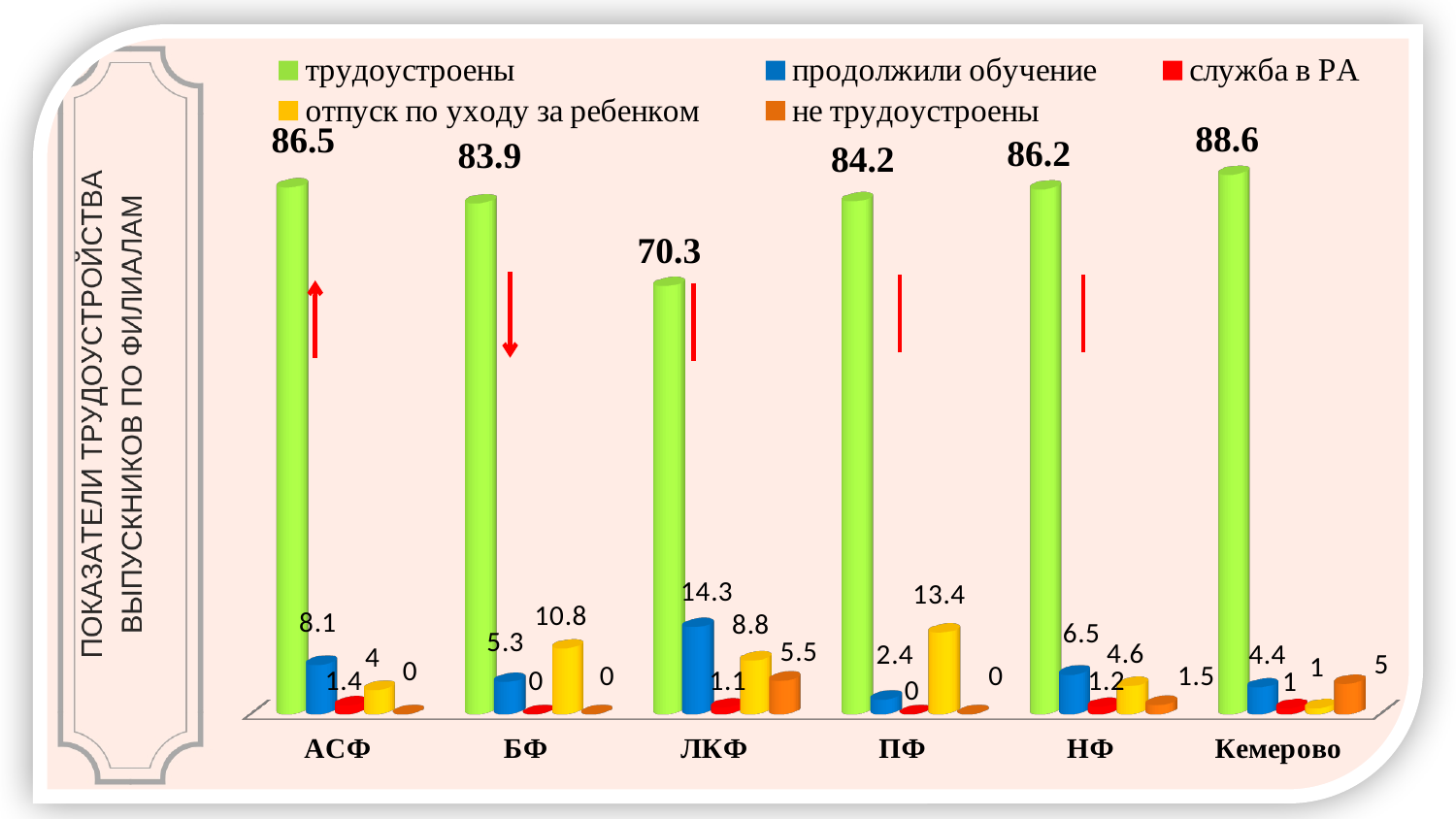
Which legend entry is shown in red? служба в РА What is the value of продолжили обучение for ЛКФ? 14.3 What is the value of трудоустроены for Кемерово? 88.6 What is the value of не трудоустроены for НФ? 1.5 What is the difference between the трудоустроены values for Кемерово and ЛКФ? 18.3 What kind of chart is shown on the slide? Bar chart How many series does the legend list? 5 Which is larger: отпуск по уходу за ребенком for БФ or for ЛКФ? БФ What is the value of отпуск по уходу за ребенком for ПФ? 13.4 Which category has the lowest value for трудоустроены? ЛКФ How many categories are shown on the x axis? 6 Which category has the highest value for трудоустроены? Кемерово